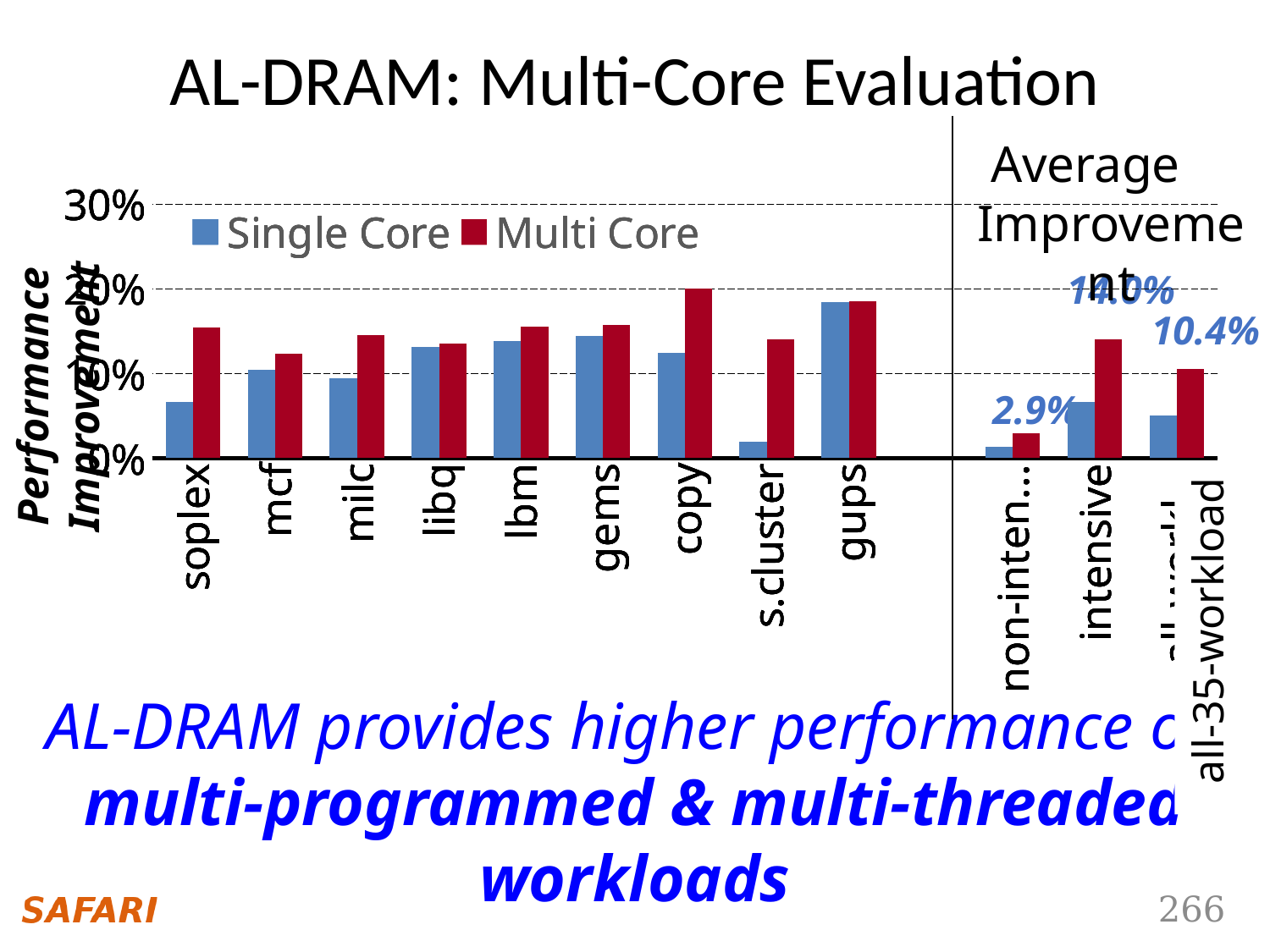
What is the Multi Core performance improvement for the all-35-workload category? 10.4% For s.cluster, which is larger: the Single Core value or the Multi Core value? Multi Core How many series does the legend list? 2 Is the Multi Core value for mcf greater or less than 10%? greater What is the Multi Core performance improvement for the non-intensive workloads? 2.9% Which category has the highest Single Core value? gups Is the Single Core value for soplex greater or less than 10%? less What kind of chart is shown on the slide? bar chart What are the two series named in the legend? Single Core and Multi Core Is the Single Core value for gups greater or less than 10%? greater What is the title of the slide containing the chart? AL-DRAM: Multi-Core Evaluation Which category has the lowest Multi Core value? non-intensive